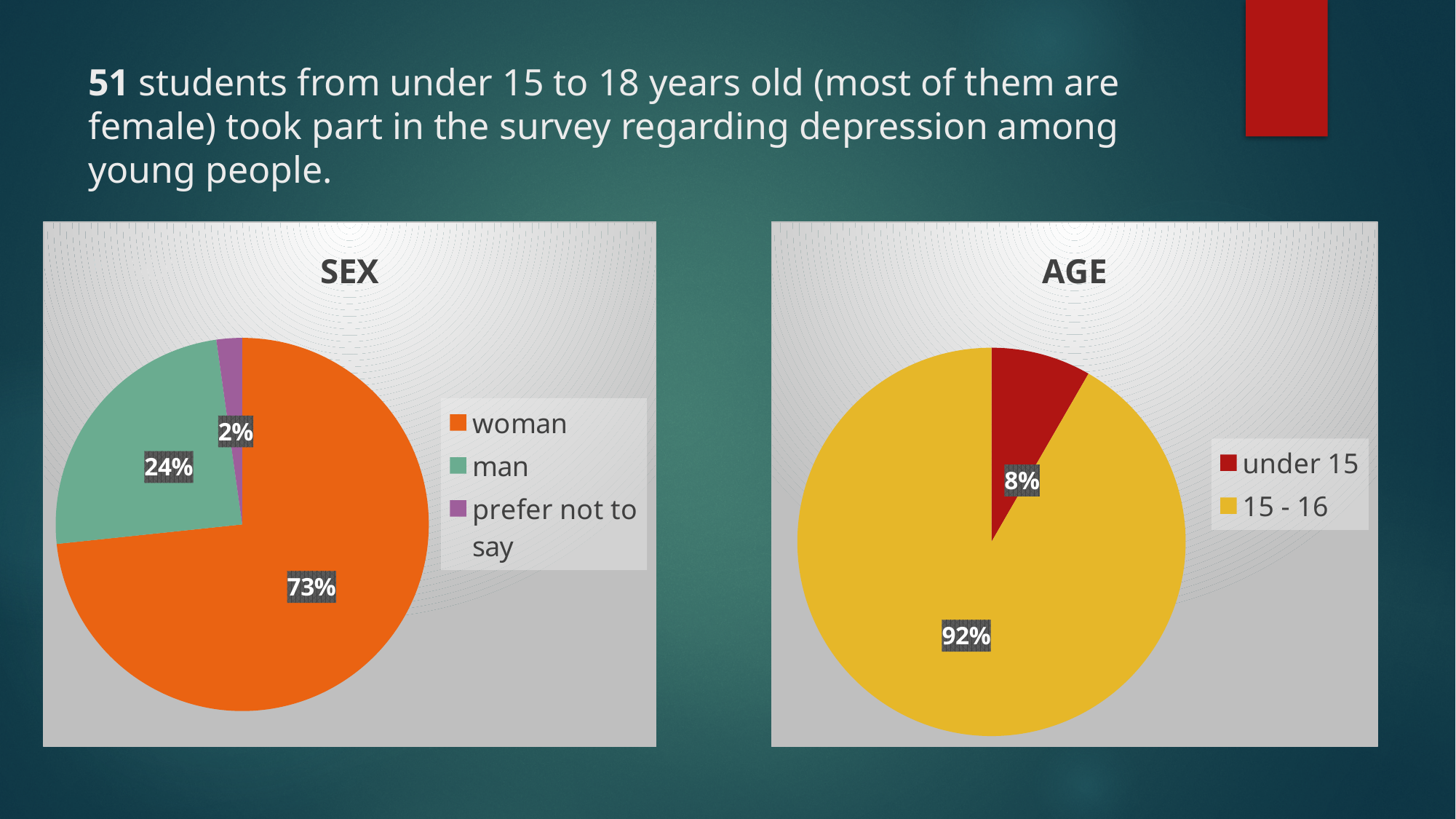
In the SEX chart, which category has the smallest slice? prefer not to say In the SEX chart, what percentage is labelled for 'man'? 24% In the AGE chart, what share of respondents are aged 15 - 16? 92% In the SEX chart, how many categories are shown in the legend? 3 In the SEX chart, what is the difference in percentage points between 'woman' and 'man'? 49 In the SEX chart, what percentage chose 'prefer not to say'? 2% In the SEX chart, which category has the largest slice? woman In the AGE chart, which is larger: 'under 15' or '15 - 16'? 15 - 16 In the SEX chart, what share of respondents are women? 73% What type of chart is the AGE chart? pie chart In the AGE chart, what percentage is labelled for 'under 15'? 8% In the AGE chart, what colour is the 'under 15' slice? red